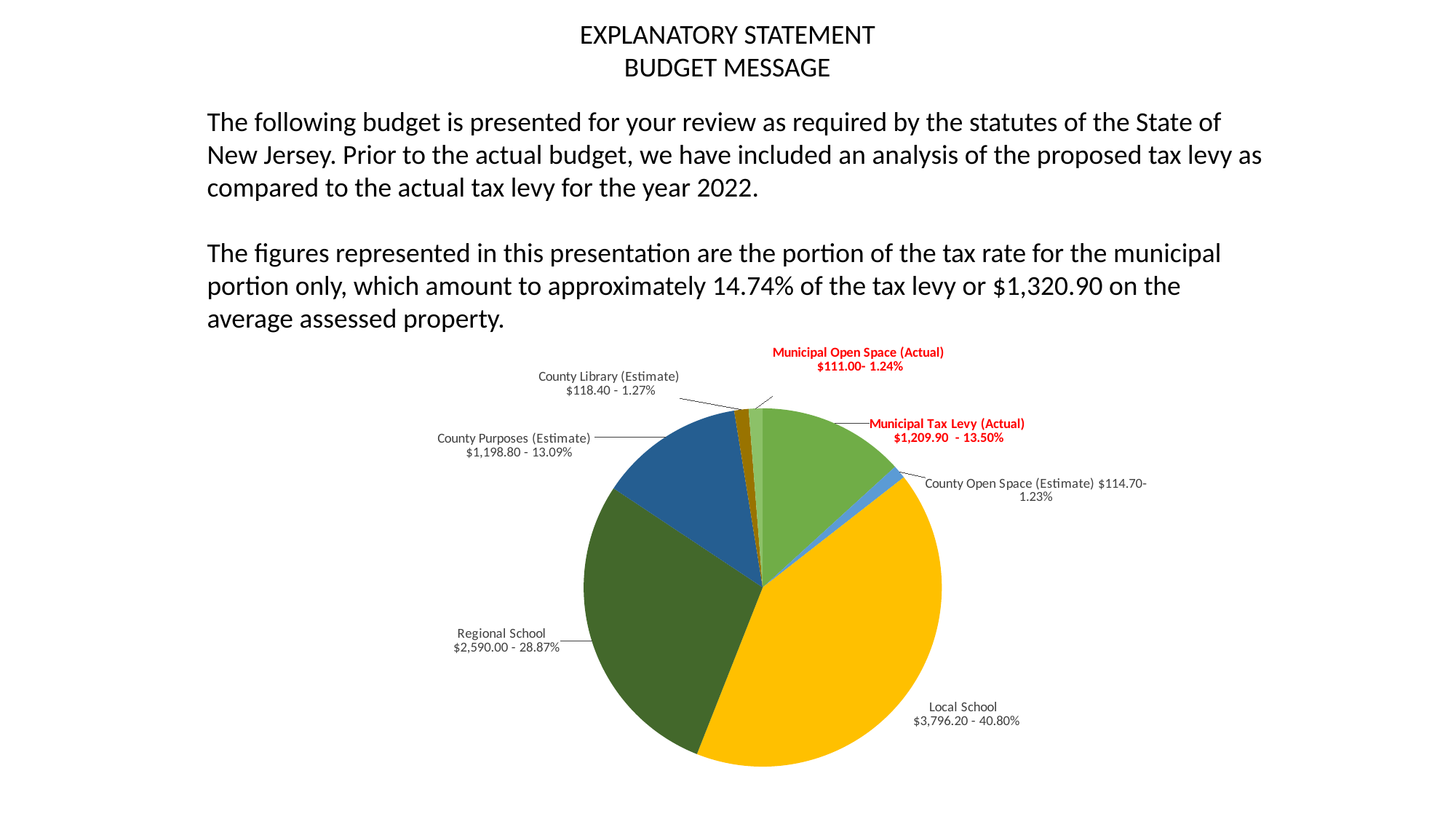
What percentage share does Regional School have in the pie chart? 28.87% Which is larger, the Regional School slice or the County Purposes (Estimate) slice? Regional School What percentage is shown for County Purposes (Estimate)? 13.09% What is the difference in dollars between Local School and Regional School? $1,206.20 What is the dollar value shown for County Library (Estimate)? $118.40 What is the dollar value shown for Municipal Tax Levy (Actual)? $1,209.90 What percentage share does Municipal Open Space (Actual) have in the pie chart? 1.24% What kind of chart is shown on the slide? pie chart Which category has the largest slice of the pie chart? Local School How many slices does the pie chart have? 7 Which two slice labels are printed in red text? Municipal Open Space (Actual) and Municipal Tax Levy (Actual) What is the dollar value shown for Local School? $3,796.20